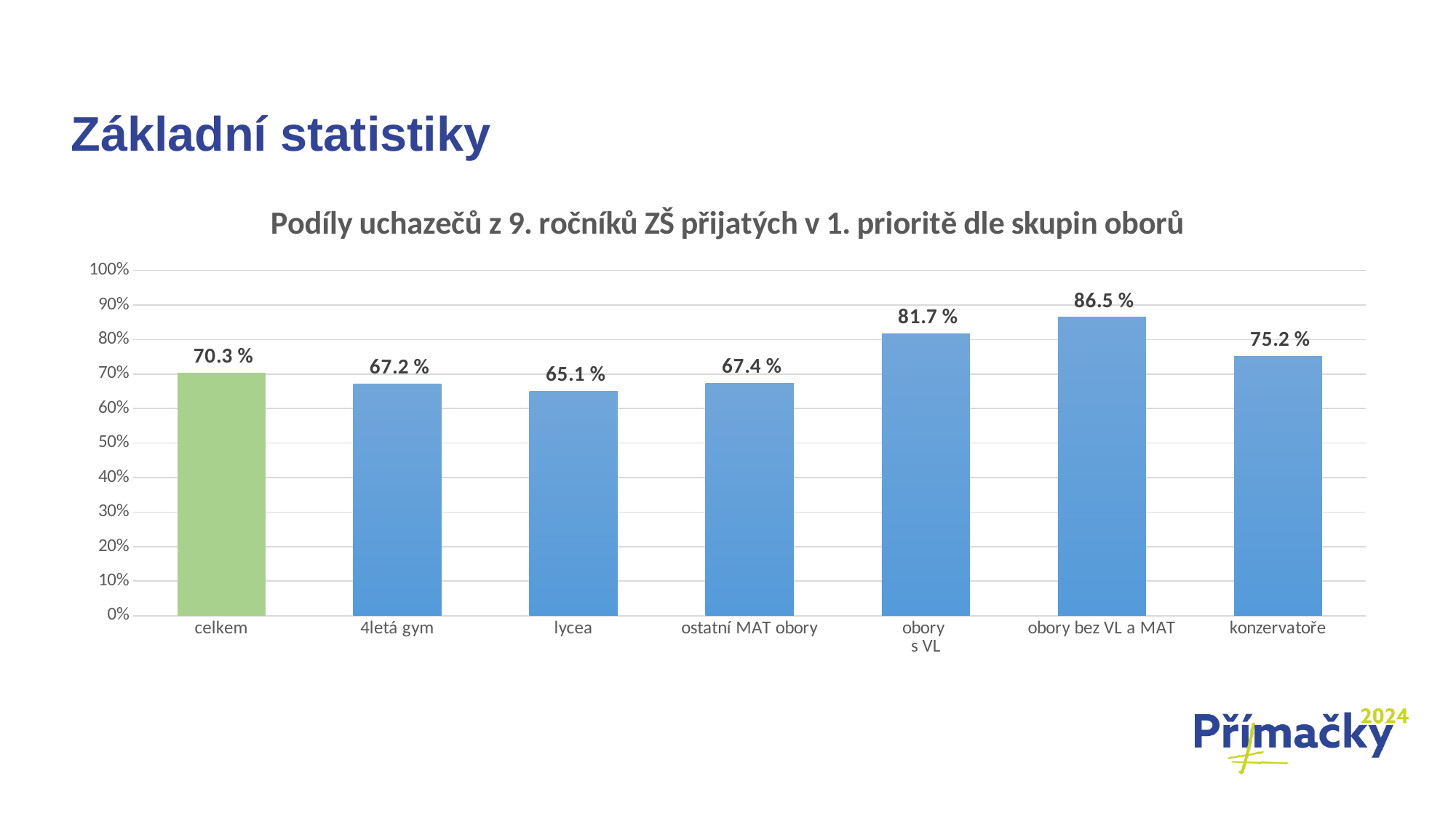
What is the difference between the values for konzervatoře and celkem? 4.9 % What is the title of the chart? Podíly uchazečů z 9. ročníků ZŠ přijatých v 1. prioritě dle skupin oborů Which category has the highest value? obory bez VL a MAT What is the difference between the values for obory bez VL a MAT and obory s VL? 4.8 % How many categories are shown on the chart? 7 What kind of chart is shown on the slide? bar chart What is the value for lycea? 65.1 % Which is larger, the value for obory s VL or the value for konzervatoře? obory s VL Which category has the lowest value? lycea What is the value for obory bez VL a MAT? 86.5 % What is the value for konzervatoře? 75.2 % What is the value for celkem? 70.3 %